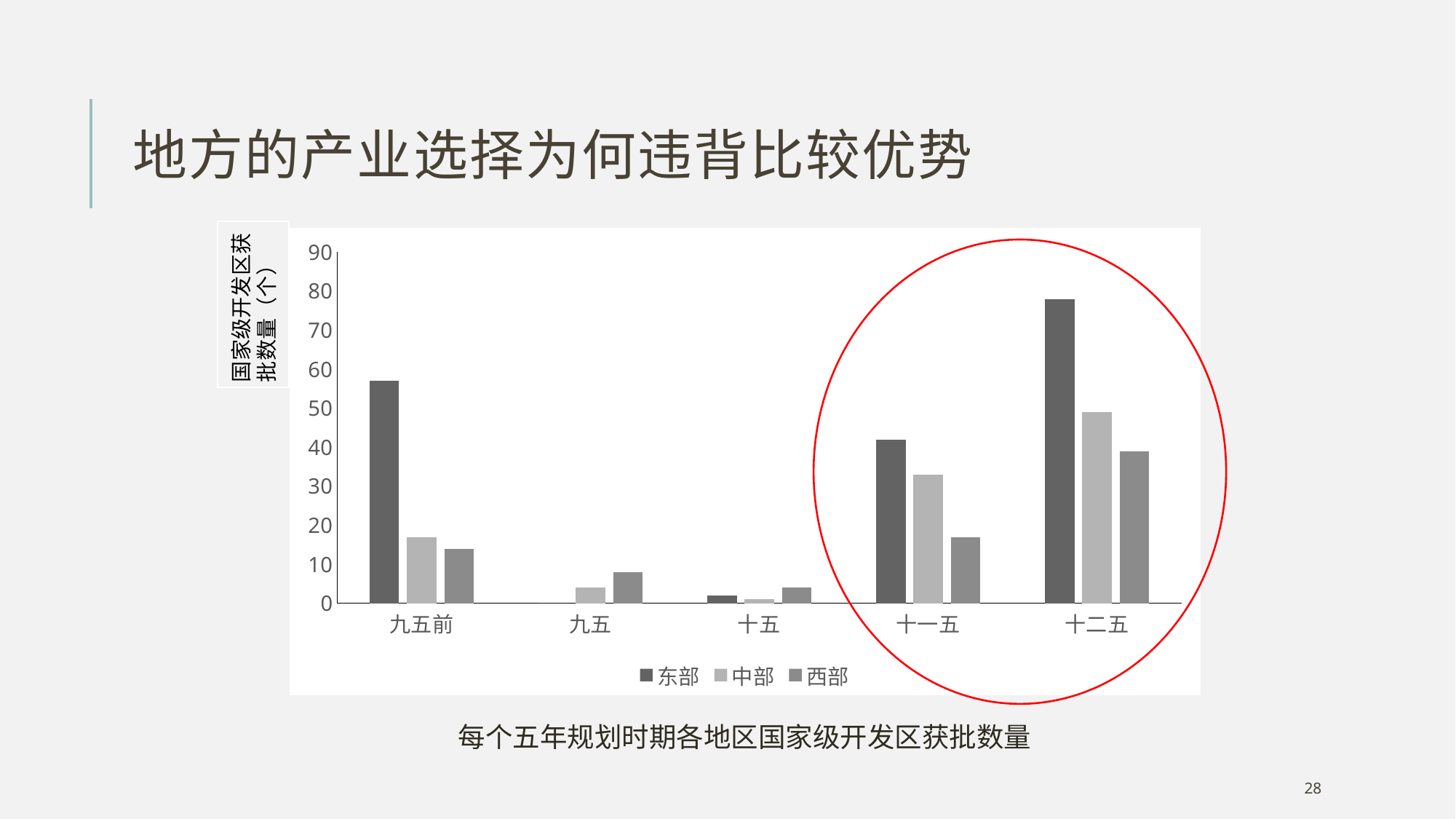
Is the value for 东部 in 十二五 greater or less than 70? greater How many series does the chart's legend list? 3 In which period is the 东部 bar the highest? 十二五 Is the value for 东部 in 九五前 greater or less than 50? greater Which is larger: the 东部 value in 九五前 or the 东部 value in 十一五? 九五前 In 九五, which is larger: the 中部 bar or the 西部 bar? 西部 What is the caption shown below the chart? 每个五年规划时期各地区国家级开发区获批数量 What kind of chart is shown on the slide? bar chart Which series has the lowest bar in 十二五? 西部 Is the value for 中部 in 十一五 greater or less than 40? less How many five-year-plan periods are shown on the x axis of the chart? 5